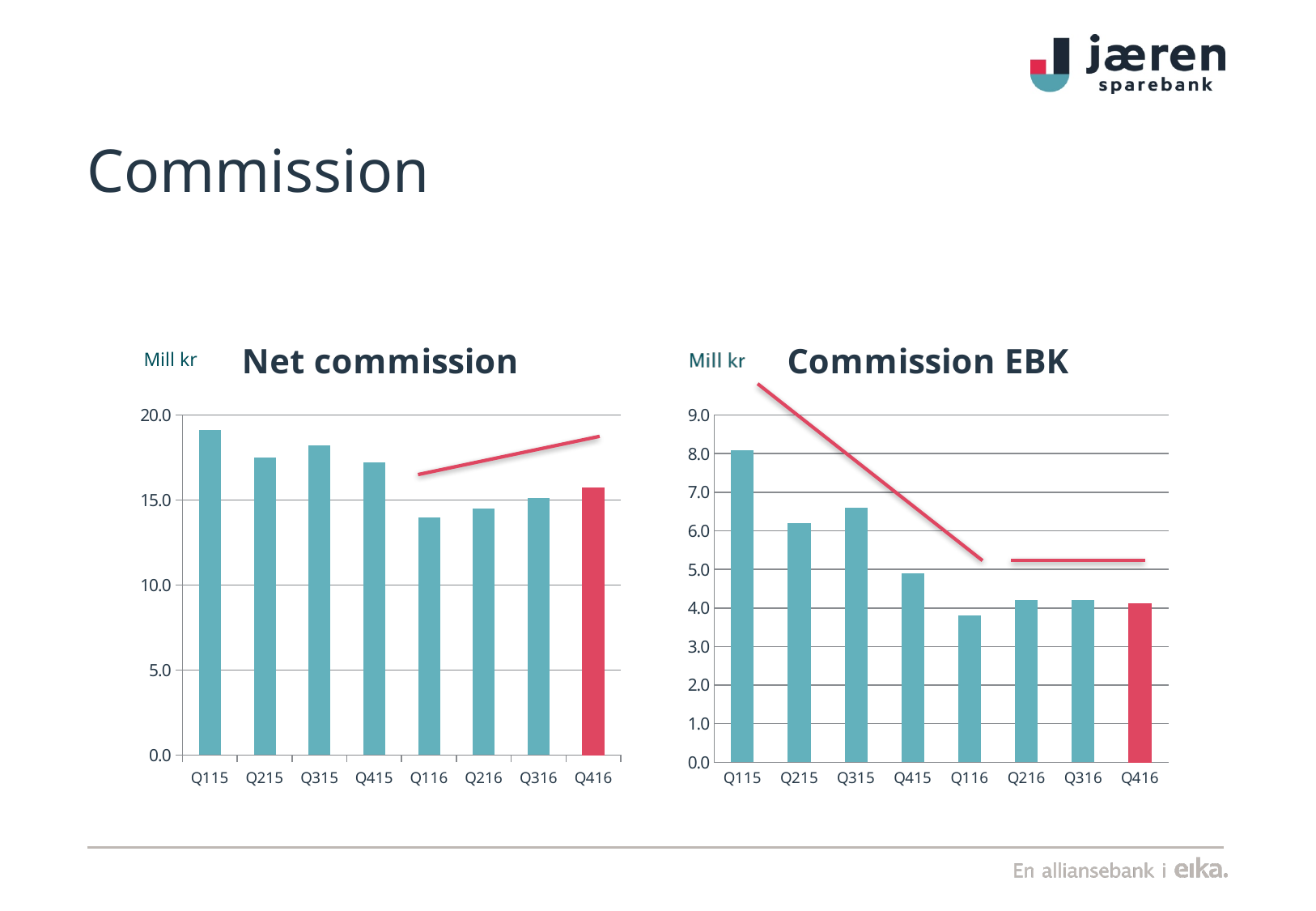
In the Commission EBK chart, which quarter has the lowest value? Q116 What kind of chart is the Commission EBK chart? bar chart In the Net commission chart, which quarter has the highest value? Q115 In the Net commission chart, which is larger, Q315 or Q215? Q315 How many quarters are shown in the Net commission chart? 8 In the Commission EBK chart, is the value for Q115 greater or less than 7.0? greater In the Net commission chart, which quarter has the lowest value? Q116 In the Net commission chart, is the value for Q116 greater or less than 15.0? less In the Commission EBK chart, which quarter has the highest value? Q115 In the Net commission chart, is the value for Q115 greater or less than 15.0? greater In the Commission EBK chart, which is larger, Q415 or Q116? Q415